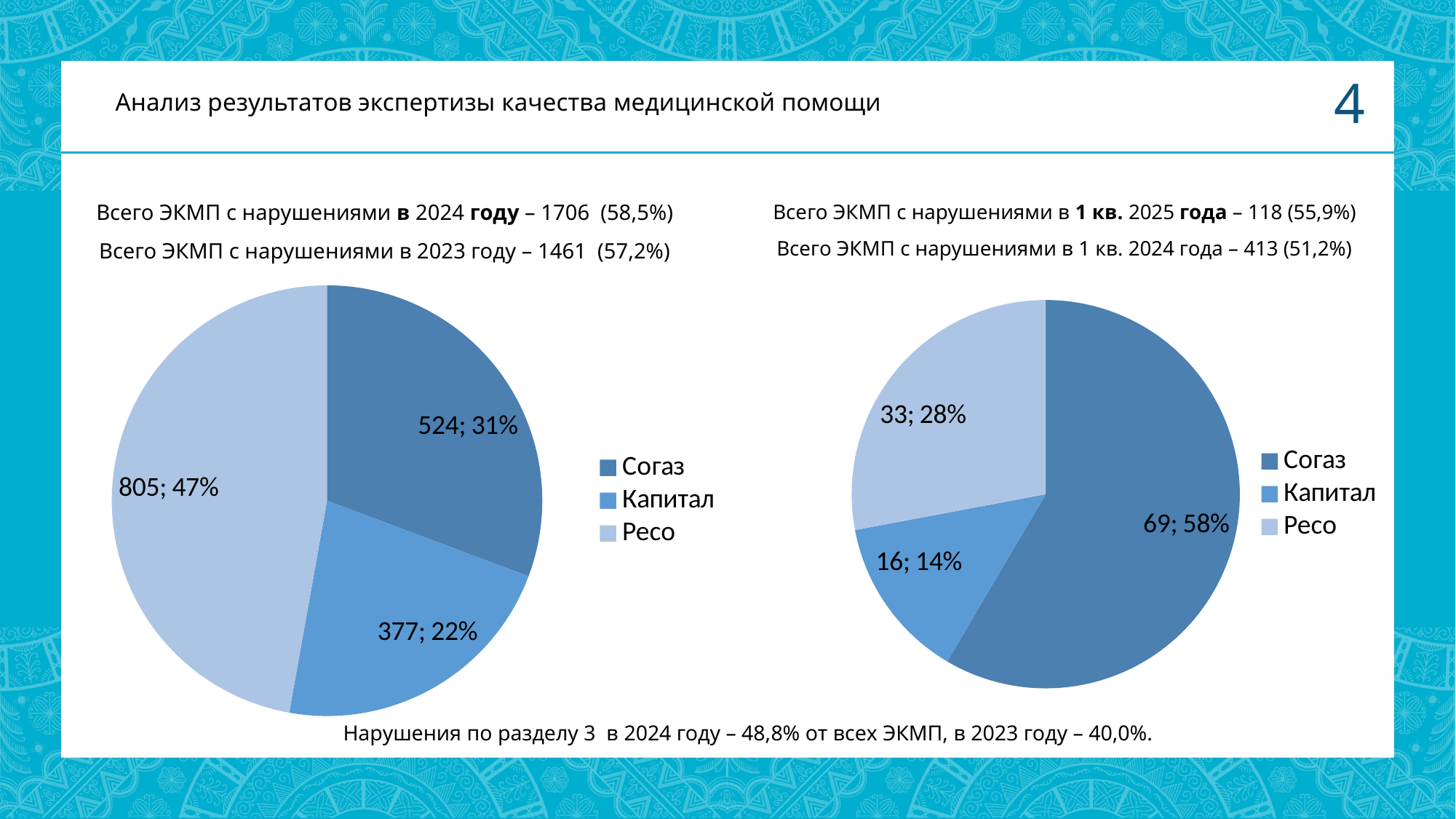
What type of chart is shown on the left of the slide? Pie chart In the left pie chart, which category has the largest slice? Ресо In the right pie chart, what is the difference between the values for Согаз and Ресо? 36 In the right pie chart, which category has the smallest slice? Капитал In the right pie chart, what is the value for Капитал? 16 In the left pie chart, what is the difference between the values for Ресо and Согаз? 281 How many slices does the right pie chart have? 3 What are the legend entries of the right pie chart? Согаз, Капитал, Ресо In the left pie chart, what is the value for Ресо? 805 In the left pie chart, what share of the pie does Согаз have? 31% In the left pie chart, which is larger: Согаз or Капитал? Согаз In the right pie chart, what share of the pie does Согаз have? 58%